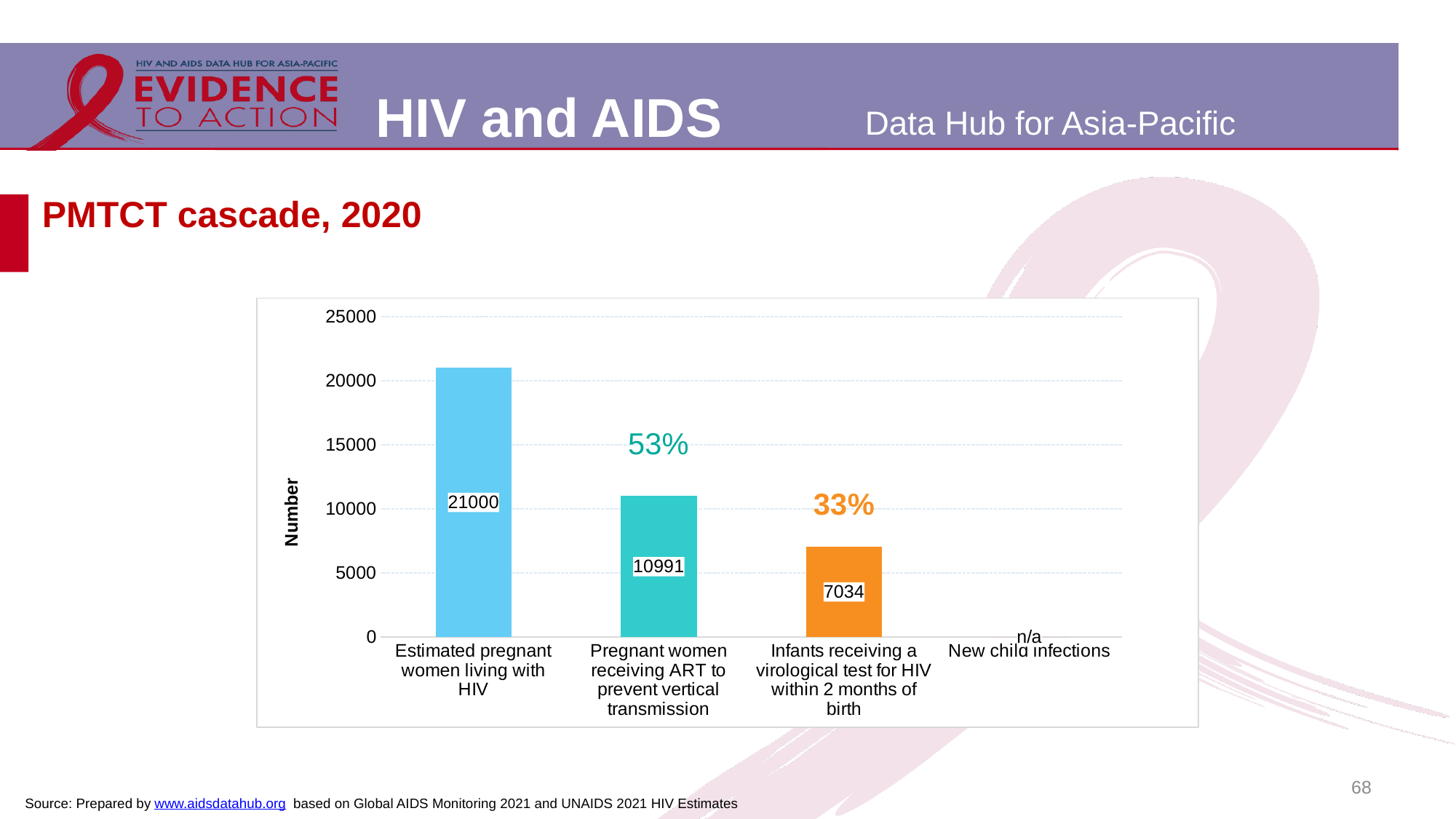
How many categories are shown on the x axis? 4 Which category has the highest value? Estimated pregnant women living with HIV What is the value for Estimated pregnant women living with HIV? 21000 What is shown for New child infections? n/a What is the value for Pregnant women receiving ART to prevent vertical transmission? 10991 What percentage is printed above the bar for Infants receiving a virological test for HIV within 2 months of birth? 33% Which is larger: Pregnant women receiving ART to prevent vertical transmission or Infants receiving a virological test for HIV within 2 months of birth? Pregnant women receiving ART to prevent vertical transmission Is the value for Estimated pregnant women living with HIV greater or less than 20000? greater What is the difference between Estimated pregnant women living with HIV and Pregnant women receiving ART to prevent vertical transmission? 10009 What kind of chart is this? bar chart Which category with a plotted bar has the lowest value? Infants receiving a virological test for HIV within 2 months of birth What is the value for Infants receiving a virological test for HIV within 2 months of birth? 7034